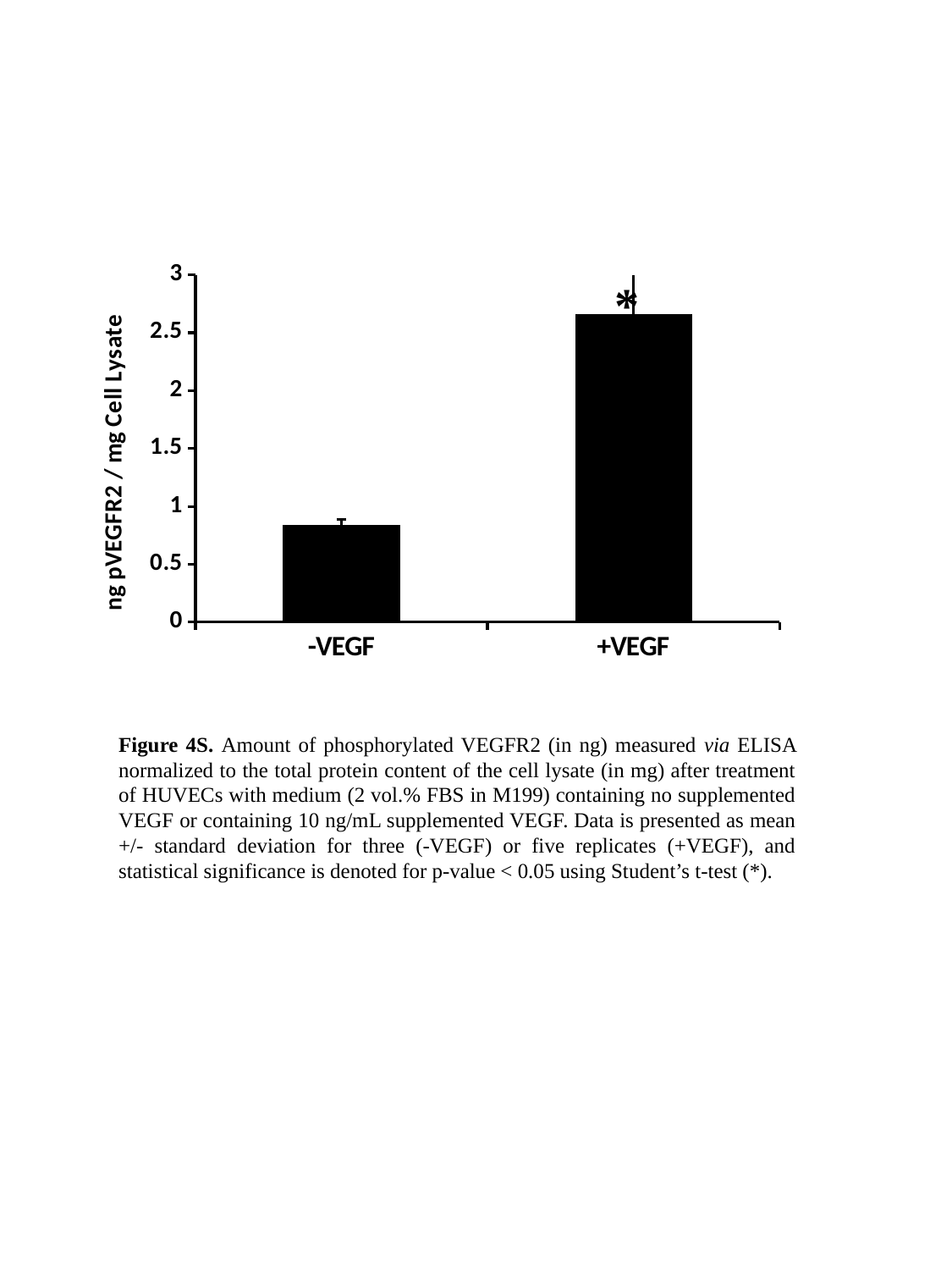
Is the value for +VEGF greater or less than 2.5? greater Which is larger, the value for -VEGF or the value for +VEGF? +VEGF Is the value for +VEGF greater or less than 3? less Which bar in the chart is marked with an asterisk? +VEGF How many categories are plotted on the x axis of the chart? 2 Is the value for -VEGF greater or less than 1? less Which category has the lowest value in the chart? -VEGF What kind of chart is shown on the slide? bar chart Which category has the highest value in the chart? +VEGF What is the title of the y axis of the chart? ng pVEGFR2 / mg Cell Lysate